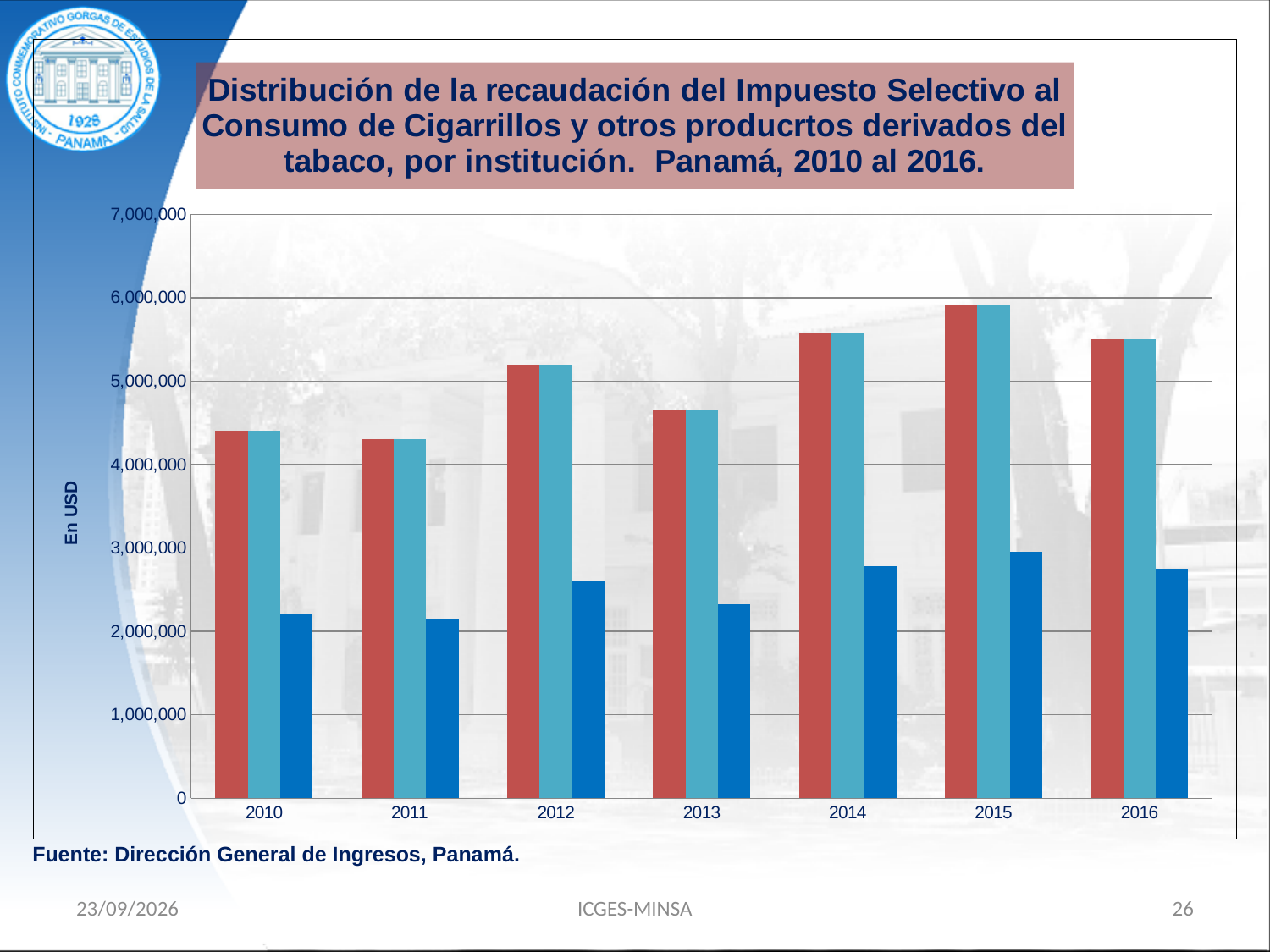
Is the value of the dark blue bar for 2016 greater or less than 3,000,000? less What kind of chart is shown on the slide? bar chart Is the value of the red bar for 2013 greater or less than 5,000,000? less What is the label on the vertical axis of the chart? En USD Which is larger, the dark blue bar for 2011 or the dark blue bar for 2012? 2012 Which is larger, the red bar for 2013 or the red bar for 2014? 2014 How many bars are plotted for each year in the chart? 3 Is the value of the dark blue bar for 2010 greater or less than 2,000,000? greater In which year is the red bar the tallest? 2015 How many years are shown on the x axis of the chart? 7 In which year is the dark blue bar the tallest? 2015